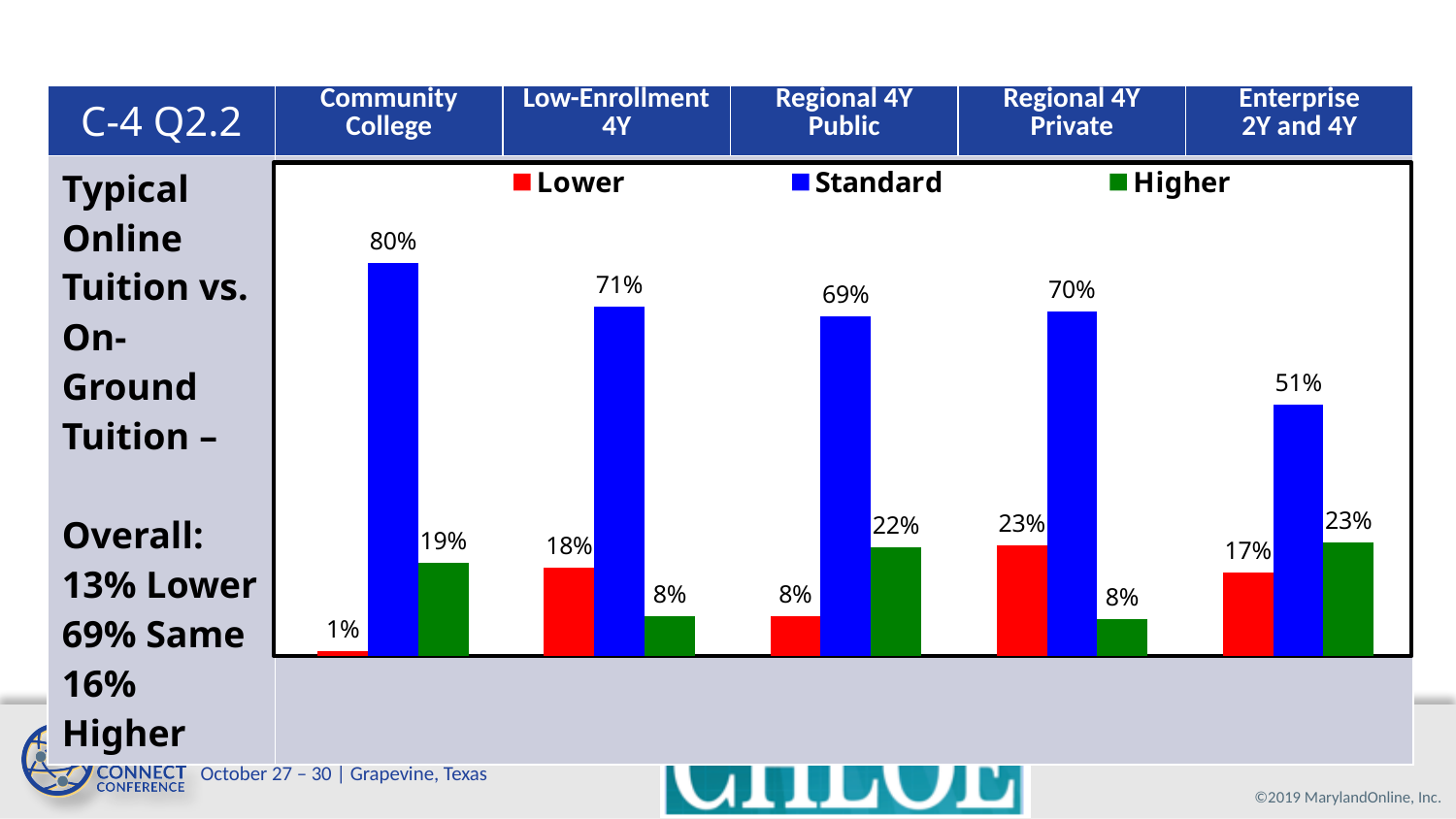
How many categories are shown on the x axis of the chart? 5 What kind of chart is shown on the slide? Bar chart Which category has the lowest Standard value? Enterprise 2Y and 4Y How many series does the legend list? 3 What colour represents the Standard series in the chart? Blue What is the Standard value for Community College? 80% What is the Higher value for Enterprise 2Y and 4Y? 23% Which category has the highest Standard value? Community College Which is larger, the Higher value for Regional 4Y Public or the Higher value for Regional 4Y Private? Regional 4Y Public What is the difference between the Standard values for Community College and Enterprise 2Y and 4Y? 29% What is the Lower value for Community College? 1% What is the Lower value for Regional 4Y Private? 23%